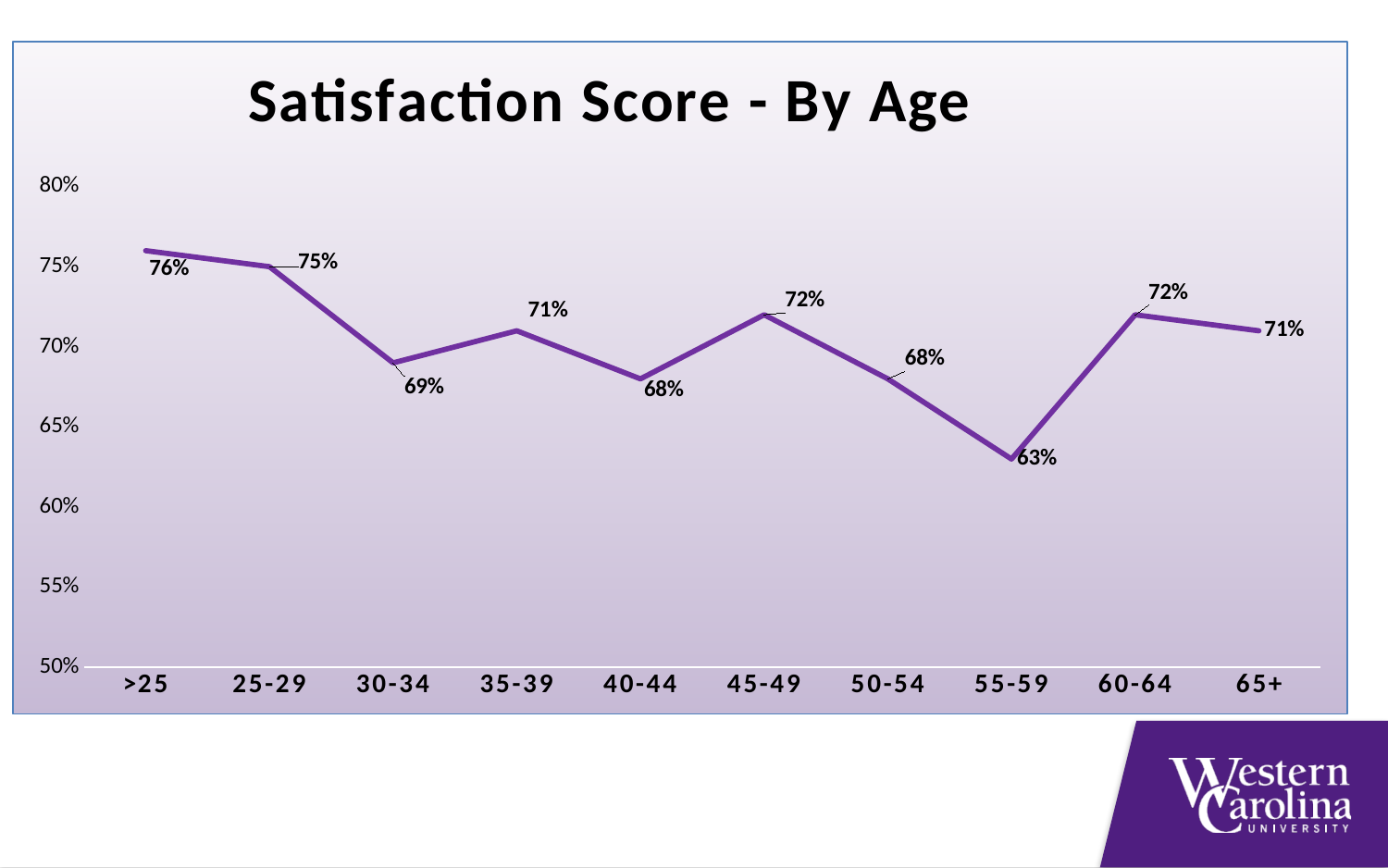
What is the difference between the satisfaction scores for the >25 and 55-59 age groups? 13% Which has a higher satisfaction score, the 35-39 age group or the 40-44 age group? 35-39 What is the title of the chart? Satisfaction Score - By Age What is the satisfaction score for the 45-49 age group? 72% What is the satisfaction score for the >25 age group? 76% What is the satisfaction score for the 55-59 age group? 63% Is the satisfaction score for the 50-54 age group greater or less than 70%? less What kind of chart is shown on the slide? line chart How many age groups are plotted on the chart? 10 Which age group has the highest satisfaction score? >25 Which age group has the lowest satisfaction score? 55-59 What is the difference between the satisfaction scores for the 25-29 and 30-34 age groups? 6%